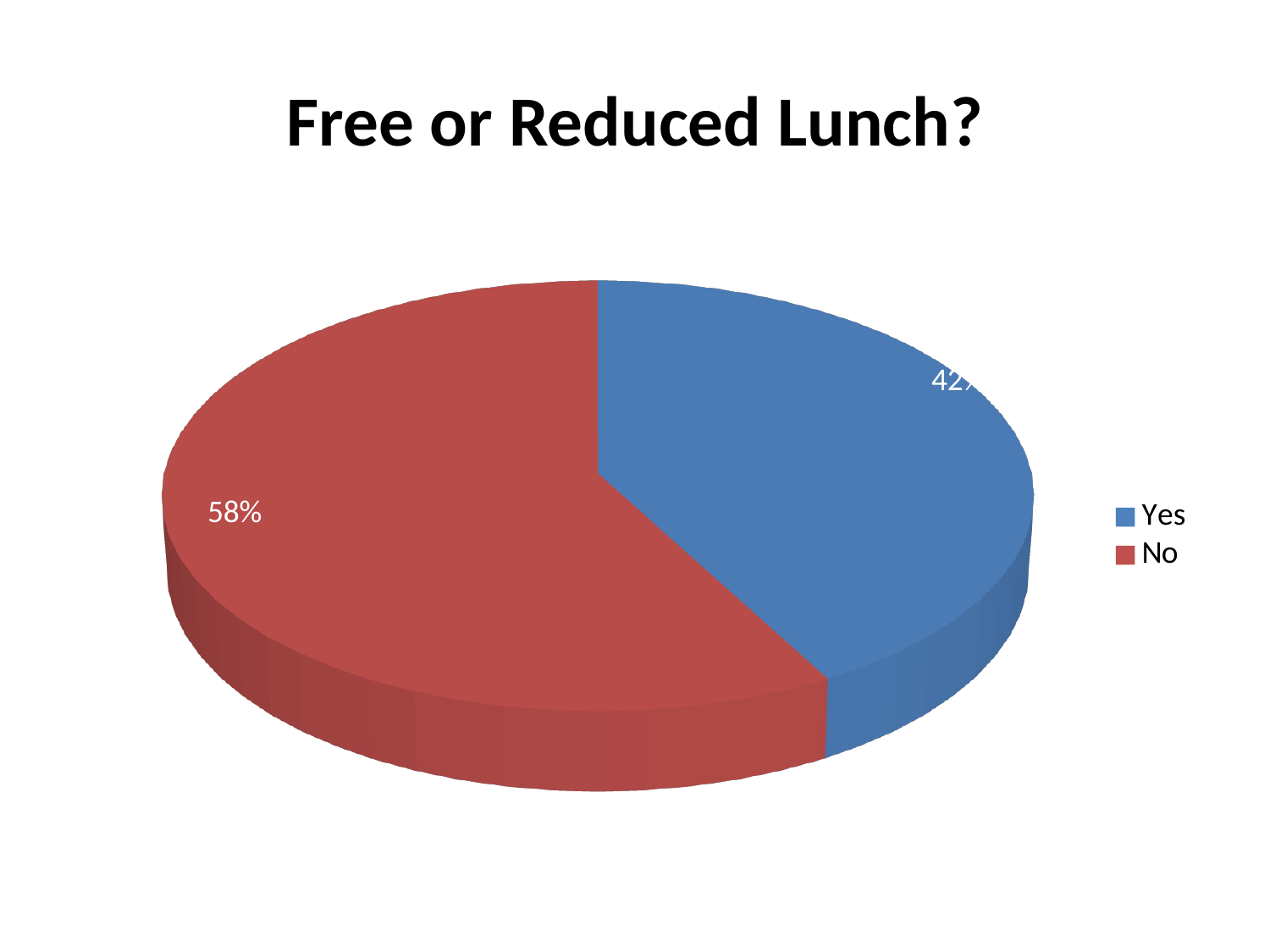
How many categories does the pie chart show? 2 What share of the pie is labelled "Yes"? 42% Which category has the smallest slice of the pie? Yes What share of the pie is labelled "No"? 58% Is the share for "No" greater or less than 50%? greater Which category has the largest slice of the pie? No How many entries does the legend list? 2 What is the title of the chart? Free or Reduced Lunch? What is the difference in percentage points between the "No" slice and the "Yes" slice? 16 What type of chart is shown on the slide? pie chart Which is larger, the "Yes" slice or the "No" slice? No What colour is the "No" slice? red